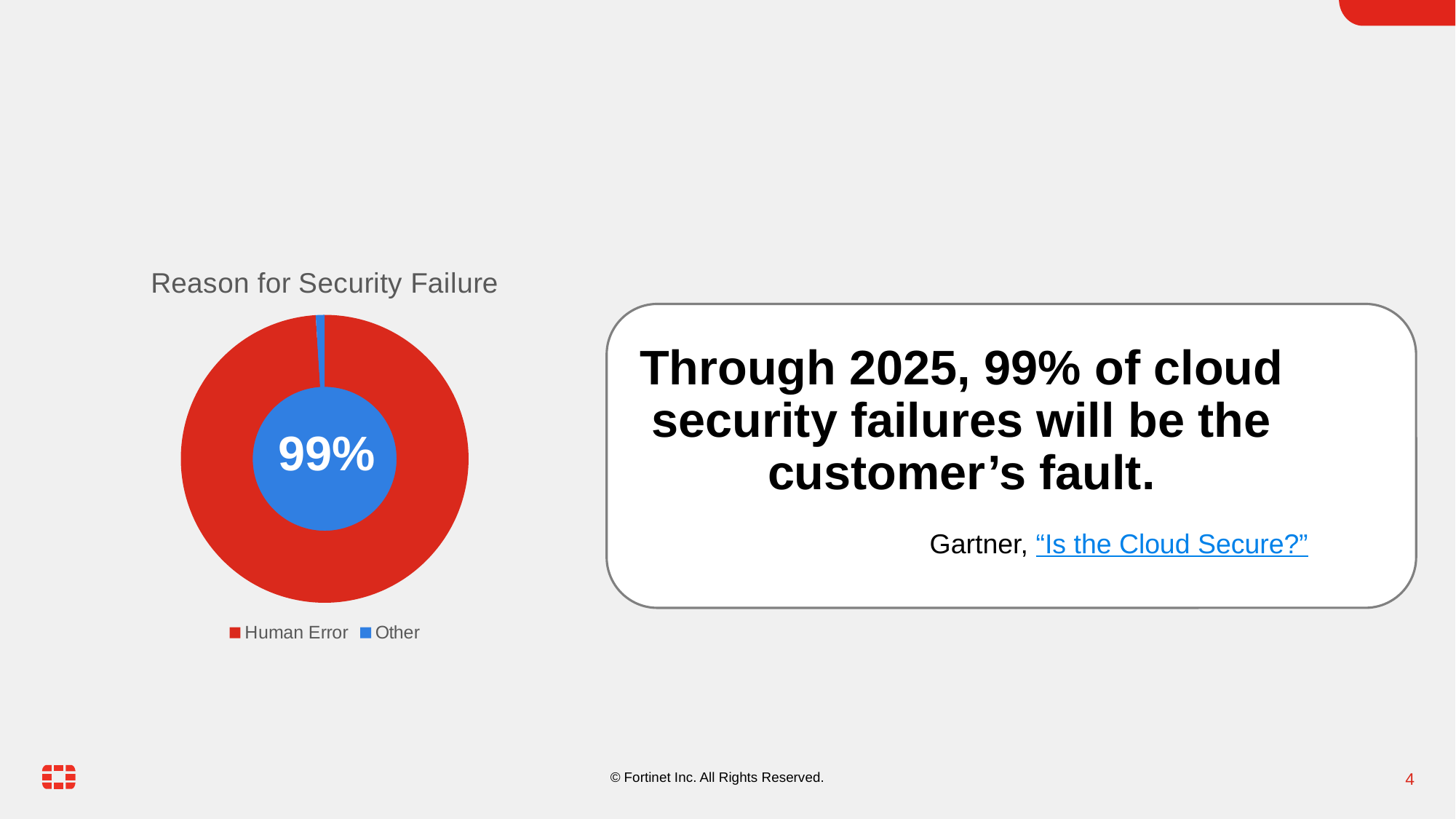
What is the title of the chart on the slide? Reason for Security Failure How many categories are shown in the "Reason for Security Failure" chart? 2 What share of security failures does the chart attribute to Human Error? 99% What colour represents Human Error in the chart? Red Which is larger in the chart, the share for Human Error or the share for Other? Human Error Which category has the smallest share in the "Reason for Security Failure" chart? Other How many entries does the chart's legend list? 2 What value is printed in the centre of the doughnut chart? 99% What type of chart is shown under the title "Reason for Security Failure"? Doughnut chart Which category has the largest share in the "Reason for Security Failure" chart? Human Error